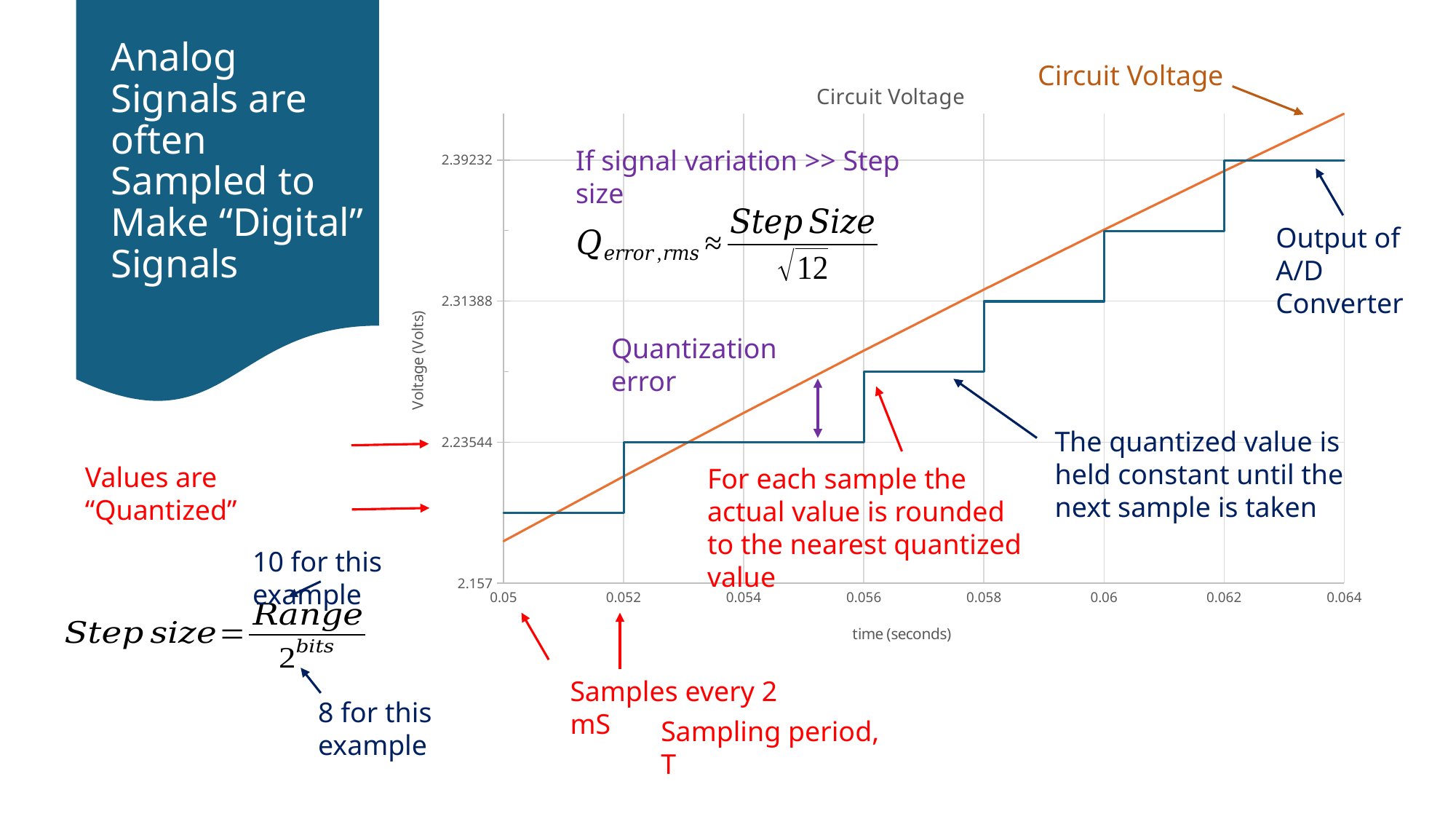
What kind of chart is shown on the slide? line chart What is the label on the vertical axis of the chart? Voltage (Volts) What is the title of the chart? Circuit Voltage Does the orange Circuit Voltage line rise or fall as time increases along the x axis? rises At 0.064 seconds, which is higher: the Circuit Voltage line or the A/D converter output? Circuit Voltage Is the Circuit Voltage at 0.064 seconds greater or less than 2.39232? greater What voltage does the A/D converter output hold between 0.052 and 0.056 seconds? 2.23544 How many tick labels are shown on the time axis? 8 What is the lowest value labelled on the voltage axis? 2.157 What voltage does the A/D converter output hold between 0.058 and 0.06 seconds? 2.31388 Is the A/D converter output at 0.05 seconds greater or less than 2.23544? less What voltage does the A/D converter output hold between 0.062 and 0.064 seconds? 2.39232